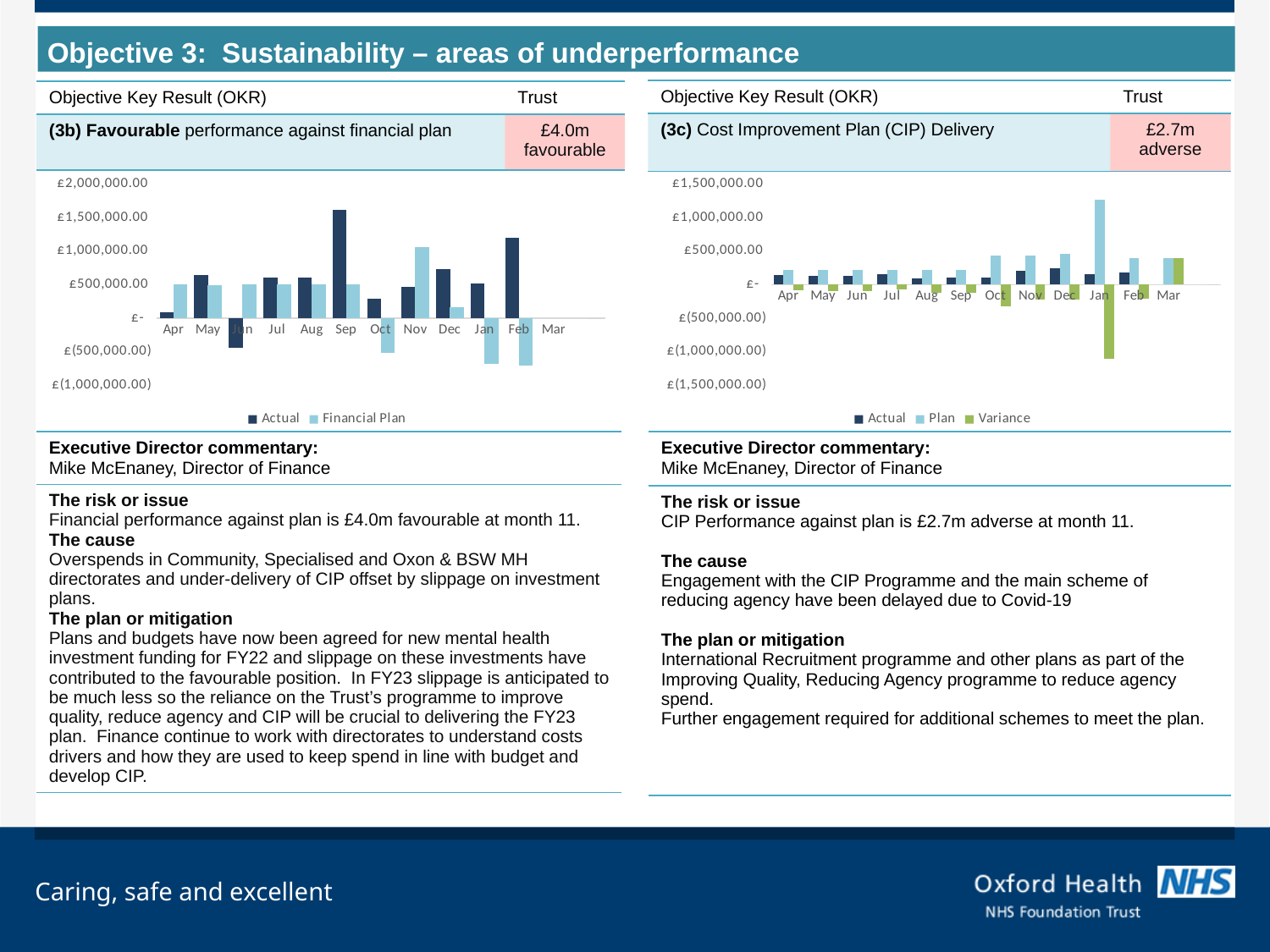
On the (3b) Favourable performance against financial plan chart, is the Actual value for Sep greater or less than £1,000,000.00? greater How many series does the legend of the (3b) Favourable performance against financial plan chart list? 2 What kind of chart is the (3c) Cost Improvement Plan (CIP) Delivery chart? bar chart On the (3b) Favourable performance against financial plan chart, in which month is the Financial Plan bar lowest? Feb On the (3c) Cost Improvement Plan (CIP) Delivery chart, is the Plan value for Jan greater or less than £1,000,000.00? greater How many months are shown on the x axis of the (3c) Cost Improvement Plan (CIP) Delivery chart? 12 On the (3b) Favourable performance against financial plan chart, which is larger in Sep, Actual or Financial Plan? Actual On the (3c) Cost Improvement Plan (CIP) Delivery chart, in which month is the Variance bar lowest? Jan On the (3b) Favourable performance against financial plan chart, is the Actual value for Oct greater or less than £500,000.00? less On the (3b) Favourable performance against financial plan chart, in which month is the Actual bar highest? Sep On the (3c) Cost Improvement Plan (CIP) Delivery chart, in which month is the Plan bar highest? Jan How many series does the legend of the (3c) Cost Improvement Plan (CIP) Delivery chart list? 3